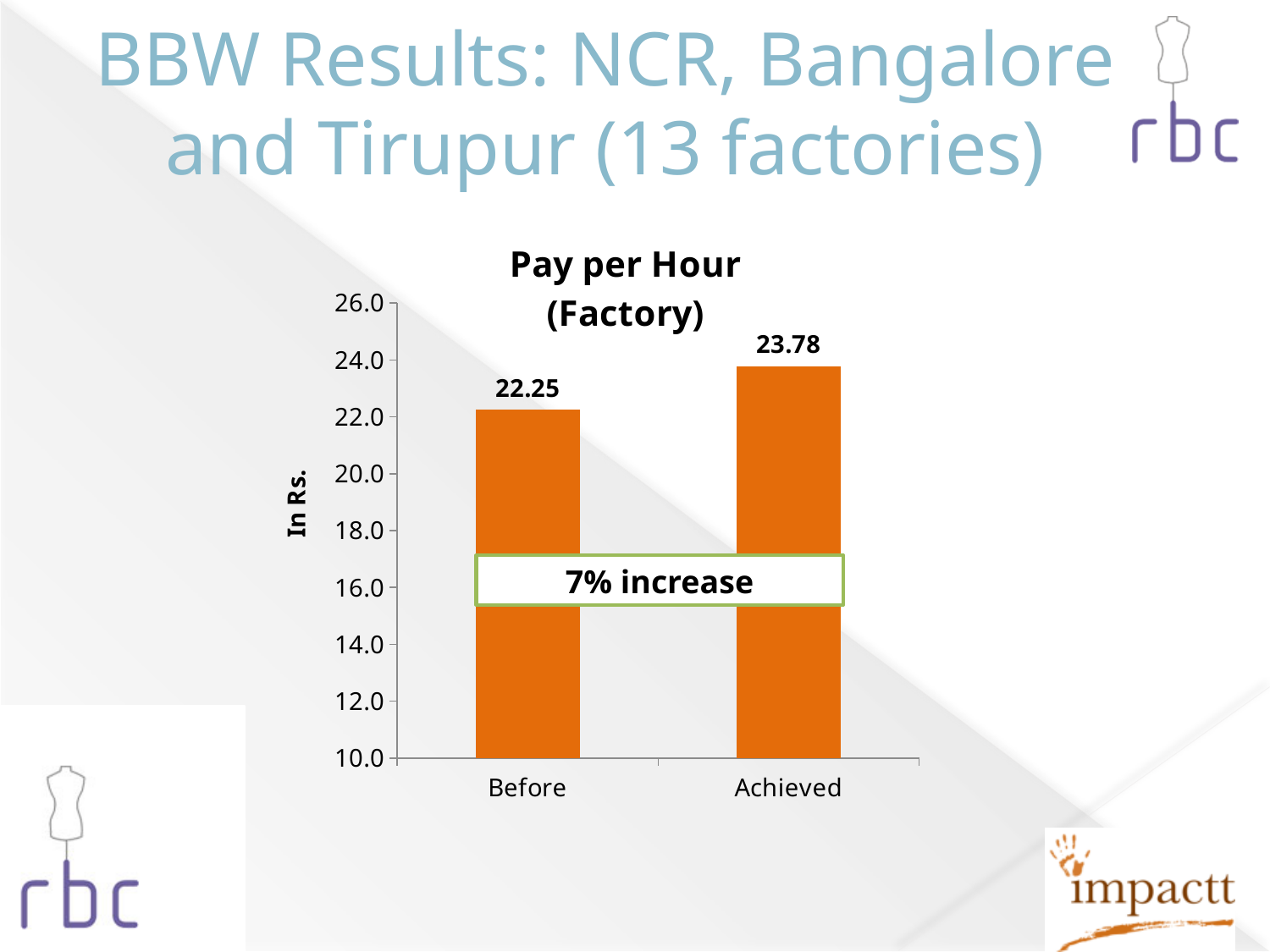
What is the pay per hour value for Before? 22.25 What is the title of the chart? Pay per Hour (Factory) Which category has the higher pay per hour, Before or Achieved? Achieved Which category has the lowest value in the chart? Before Is the value for Before greater or less than 22.0? greater What kind of chart is shown on the slide? bar chart Is the value for Achieved greater or less than 24.0? less Do the values rise or fall from Before to Achieved? rise What is the difference between the Achieved and Before values? 1.53 What is the pay per hour value for Achieved? 23.78 What percentage increase is annotated on the chart? 7% increase How many categories are shown on the x axis? 2